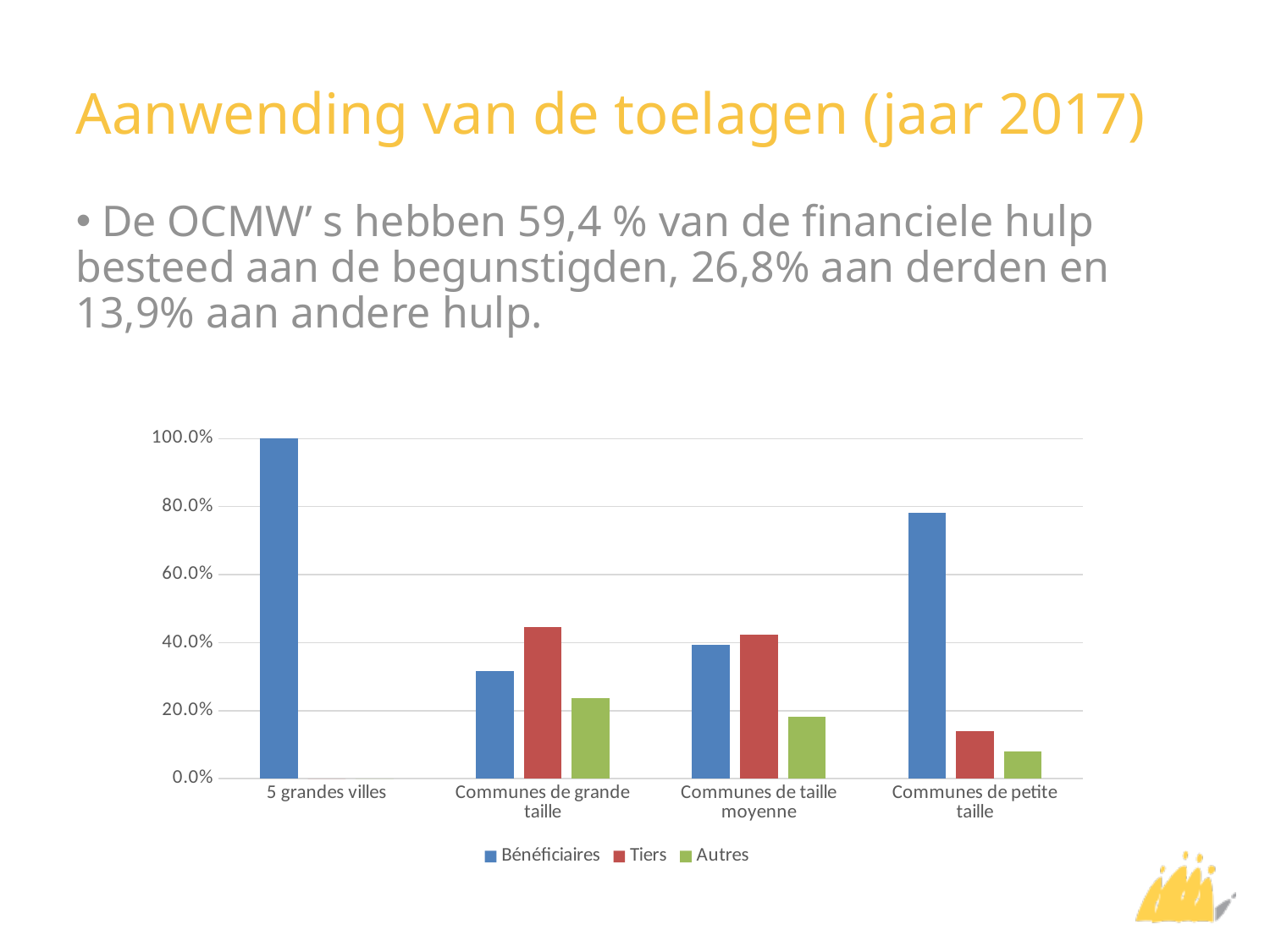
What is the Bénéficiaires value for 5 grandes villes? 100.0% Is the Tiers value for Communes de grande taille greater or less than 40%? greater Is the Tiers value for Communes de petite taille greater or less than 20%? less How many series does the chart legend list? 3 What type of chart is shown on the slide? bar chart Is the Bénéficiaires value for Communes de petite taille greater or less than 60%? greater Which series is shown in green in the chart legend? Autres For Communes de petite taille, which is larger: Bénéficiaires or Autres? Bénéficiaires For Communes de grande taille, which is larger: Bénéficiaires or Tiers? Tiers How many categories are shown on the x axis of the chart? 4 Which category has the highest Bénéficiaires value? 5 grandes villes